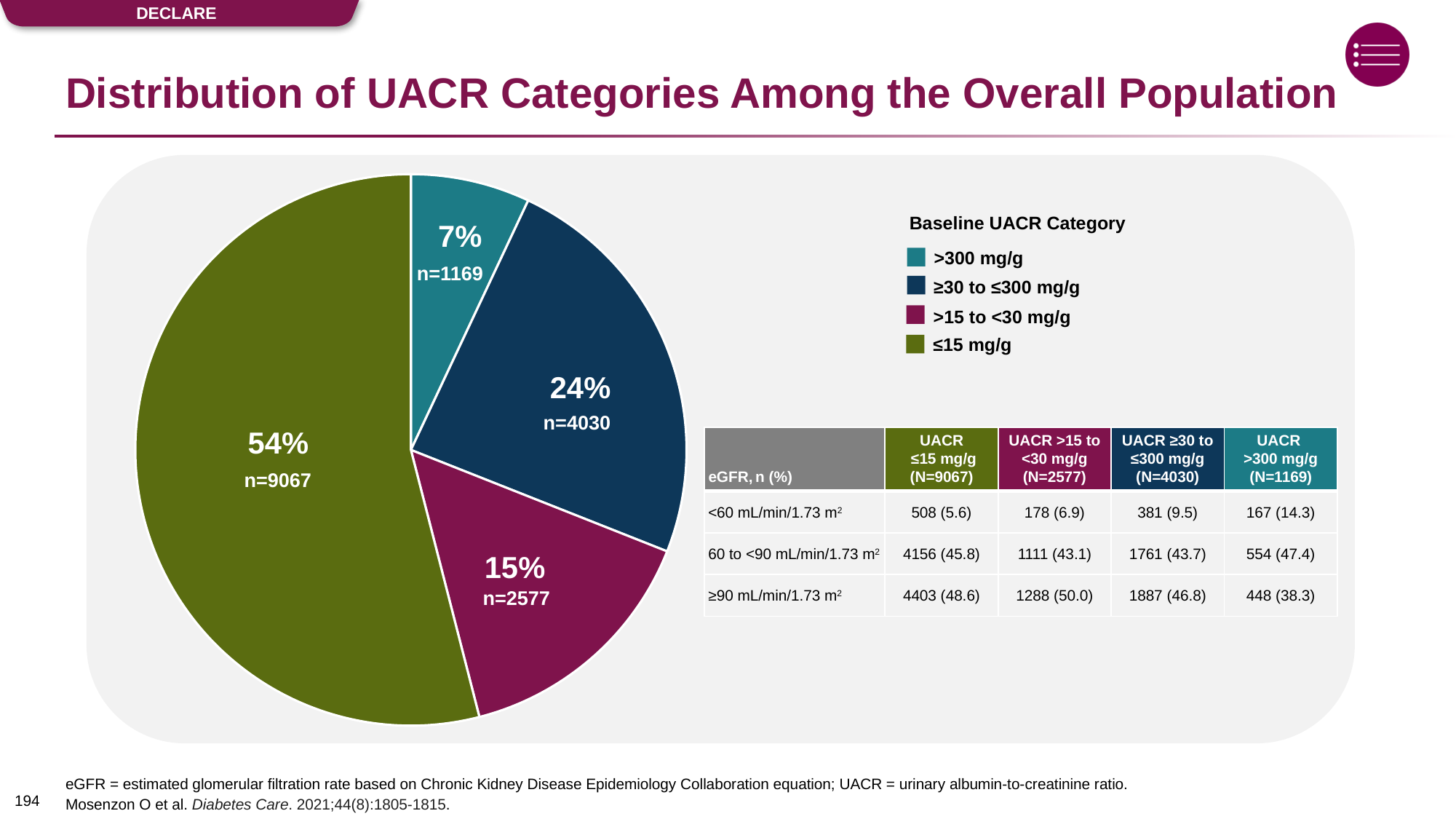
What is the difference in percentage points between the ≥30 to ≤300 mg/g slice and the >15 to <30 mg/g slice? 9% What share of the pie does the ≤15 mg/g UACR category represent? 54% What is the n value shown for the ≥30 to ≤300 mg/g slice? n=4030 How many entries does the legend list? 4 Which UACR category has the smallest slice of the pie? >300 mg/g Which slice is larger: >15 to <30 mg/g or ≥30 to ≤300 mg/g? ≥30 to ≤300 mg/g What kind of chart is shown on the slide? pie chart How many UACR categories are shown in the pie chart? 4 What share of the pie does the >300 mg/g UACR category represent? 7% Which UACR category has the largest slice of the pie? ≤15 mg/g What is the n value shown for the >15 to <30 mg/g slice? n=2577 What is the title of the legend for the pie chart? Baseline UACR Category